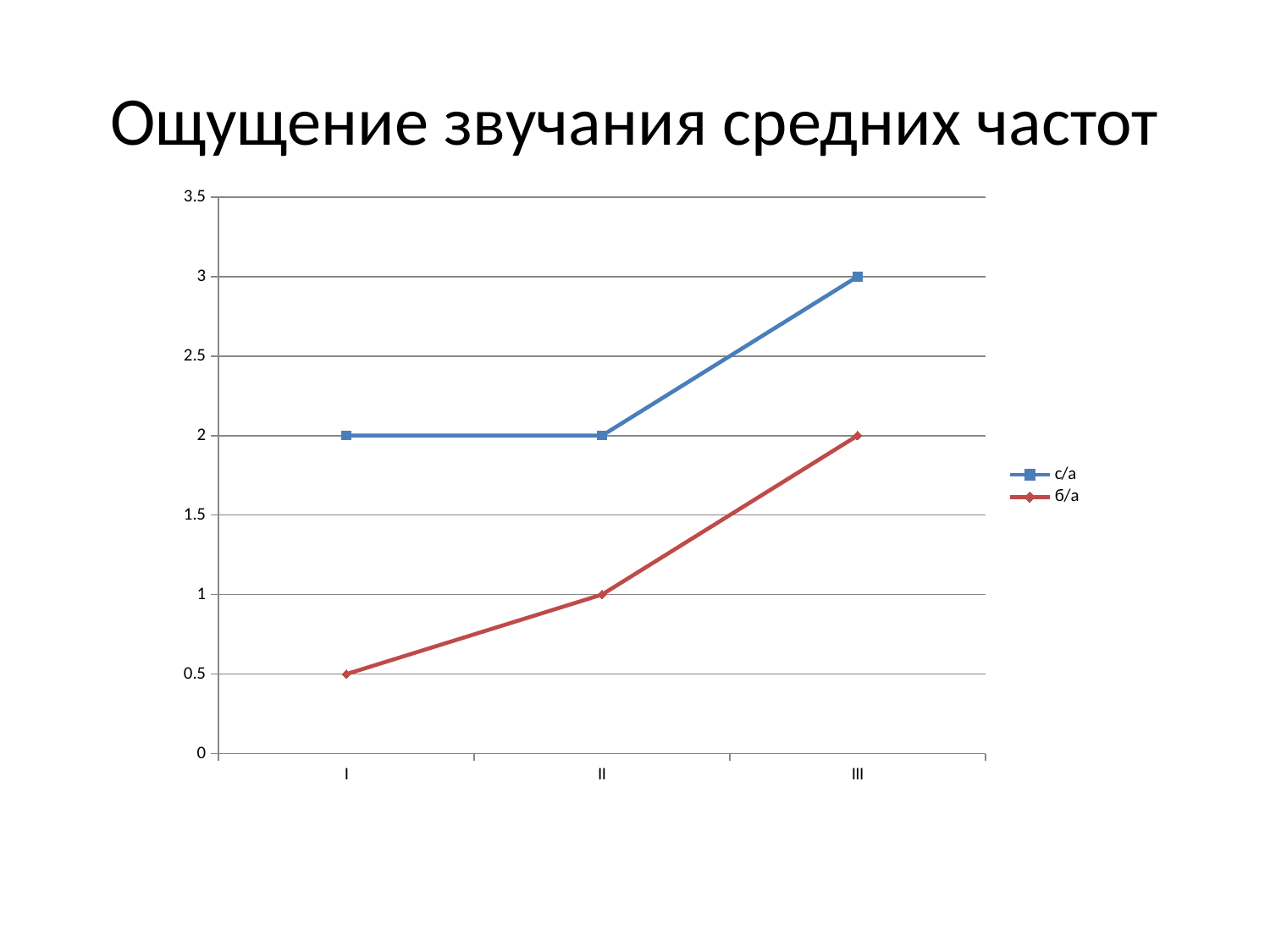
Does the б/а series rise or fall from category I to category III? rise What is the value of the б/а series at category II? 1 At which category is the б/а series highest? III What is the difference between the с/а and б/а values at category II? 1 What kind of chart is shown on the slide? line chart What is the value of the б/а series at category I? 0.5 How many categories are shown on the x axis? 3 What is the title of the chart? Ощущение звучания средних частот What is the value of the с/а series at category III? 3 How many series does the legend list? 2 At which category is the б/а series lowest? I Which series has the larger value at category I, с/а or б/а? с/а